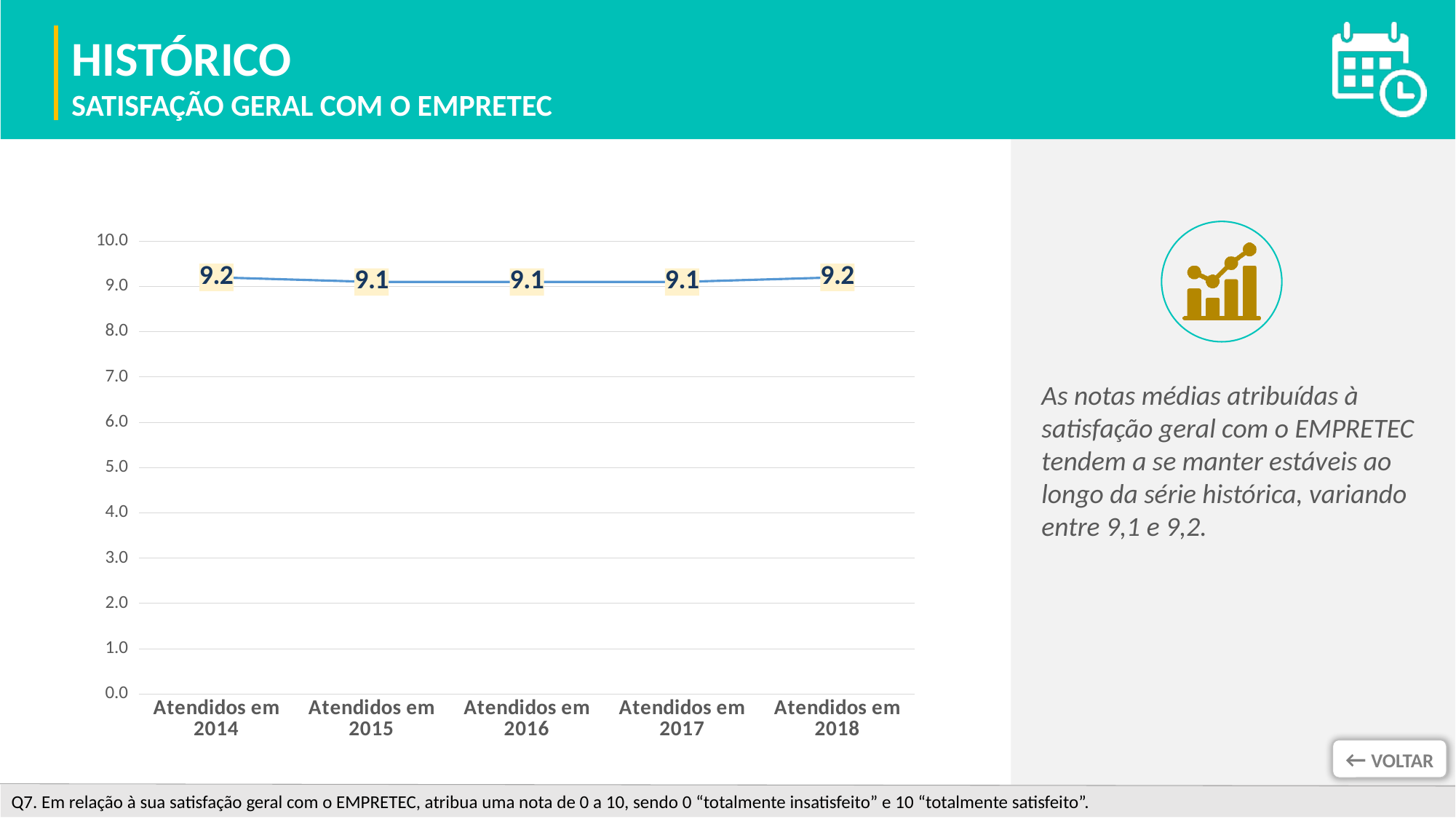
What kind of chart is shown on the slide? line chart What is the value for Atendidos em 2014? 9.2 What is the value for Atendidos em 2016? 9.1 What is the maximum value shown on the y axis? 10.0 Is the value for Atendidos em 2015 greater or less than 8.0? greater What is the value for Atendidos em 2018? 9.2 How many categories are plotted on the x axis? 5 What is the highest value shown on the chart? 9.2 What is the lowest value shown on the chart? 9.1 What is the difference between the values for Atendidos em 2018 and Atendidos em 2017? 0.1 Which is larger, the value for Atendidos em 2014 or Atendidos em 2015? Atendidos em 2014 What is the value for Atendidos em 2017? 9.1